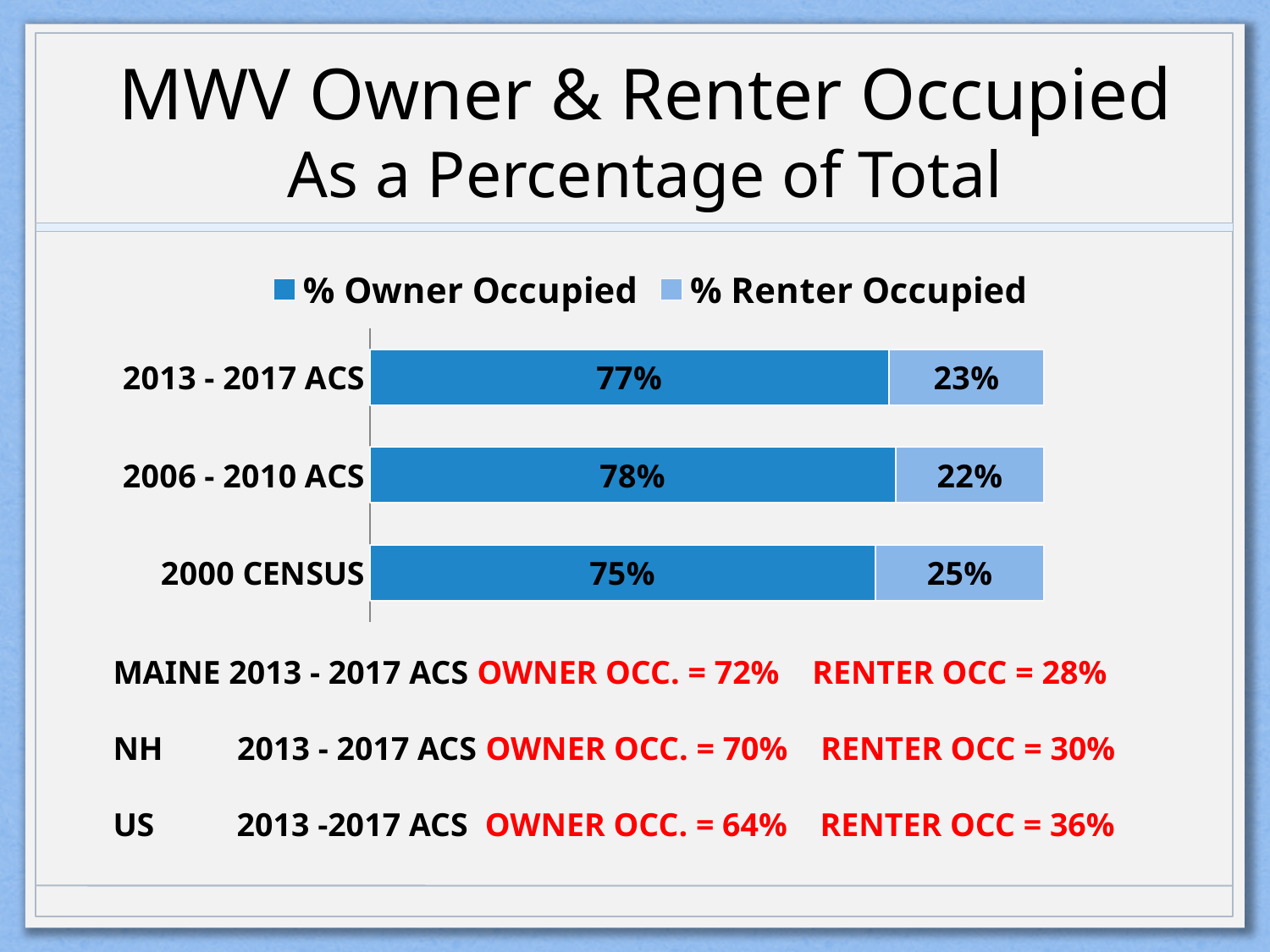
What is the % Renter Occupied value for 2006 - 2010 ACS? 22% Which category has the lowest % Owner Occupied value? 2000 CENSUS How many categories are shown on the chart? 3 Which is larger: the % Renter Occupied value for 2000 CENSUS or for 2006 - 2010 ACS? 2000 CENSUS Which category has the highest % Owner Occupied value? 2006 - 2010 ACS What is the difference between the % Owner Occupied and % Renter Occupied values for 2013 - 2017 ACS? 54% What kind of chart is shown on the slide? Stacked bar chart What is the title of the chart on the slide? MWV Owner & Renter Occupied As a Percentage of Total How many series does the legend list? 2 What is the total of the stacked bar for 2006 - 2010 ACS? 100% What is the % Renter Occupied value for 2000 CENSUS? 25% What is the % Owner Occupied value for 2013 - 2017 ACS? 77%